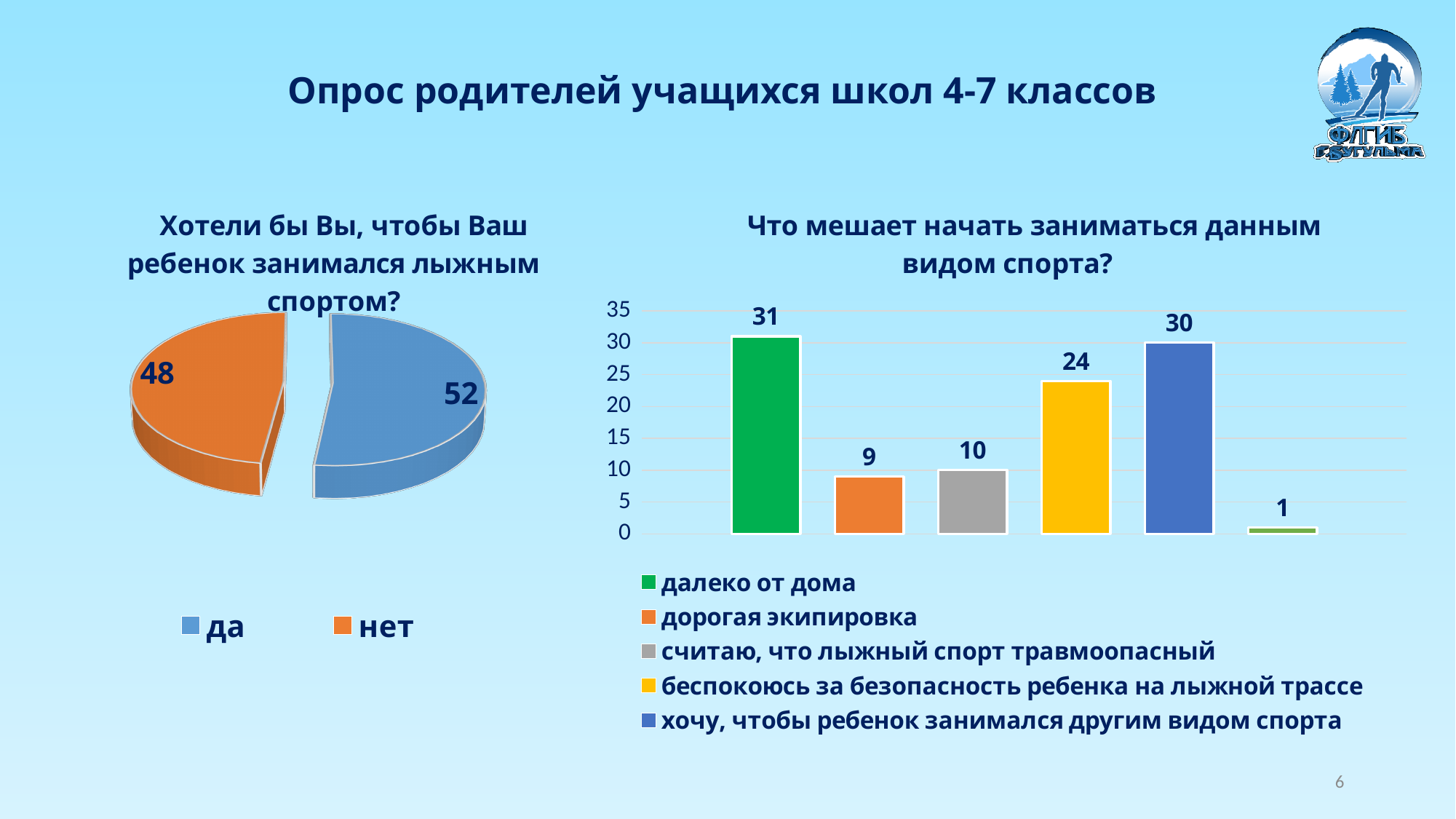
In the chart titled "Что мешает начать заниматься данным видом спорта?", which is larger, "считаю, что лыжный спорт травмоопасный" or "хочу, чтобы ребенок занимался другим видом спорта"? хочу, чтобы ребенок занимался другим видом спорта In the pie chart on the left, what is the value for "да"? 52 How many entries does the legend of the chart titled "Что мешает начать заниматься данным видом спорта?" list? 5 In the chart titled "Что мешает начать заниматься данным видом спорта?", what is the value for "беспокоюсь за безопасность ребенка на лыжной трассе"? 24 In the pie chart on the left, what is the value for "нет"? 48 In the chart titled "Что мешает начать заниматься данным видом спорта?", which category has the highest value? далеко от дома How many bars are plotted in the chart titled "Что мешает начать заниматься данным видом спорта?"? 6 In the chart titled "Что мешает начать заниматься данным видом спорта?", what is the difference between the values for "далеко от дома" and "дорогая экипировка"? 22 What kind of chart is the chart on the right of the slide? bar chart In the pie chart on the left, which is larger, "да" or "нет"? да In the chart titled "Что мешает начать заниматься данным видом спорта?", what is the value for "далеко от дома"? 31 In the pie chart on the left, what is the difference between the values for "да" and "нет"? 4